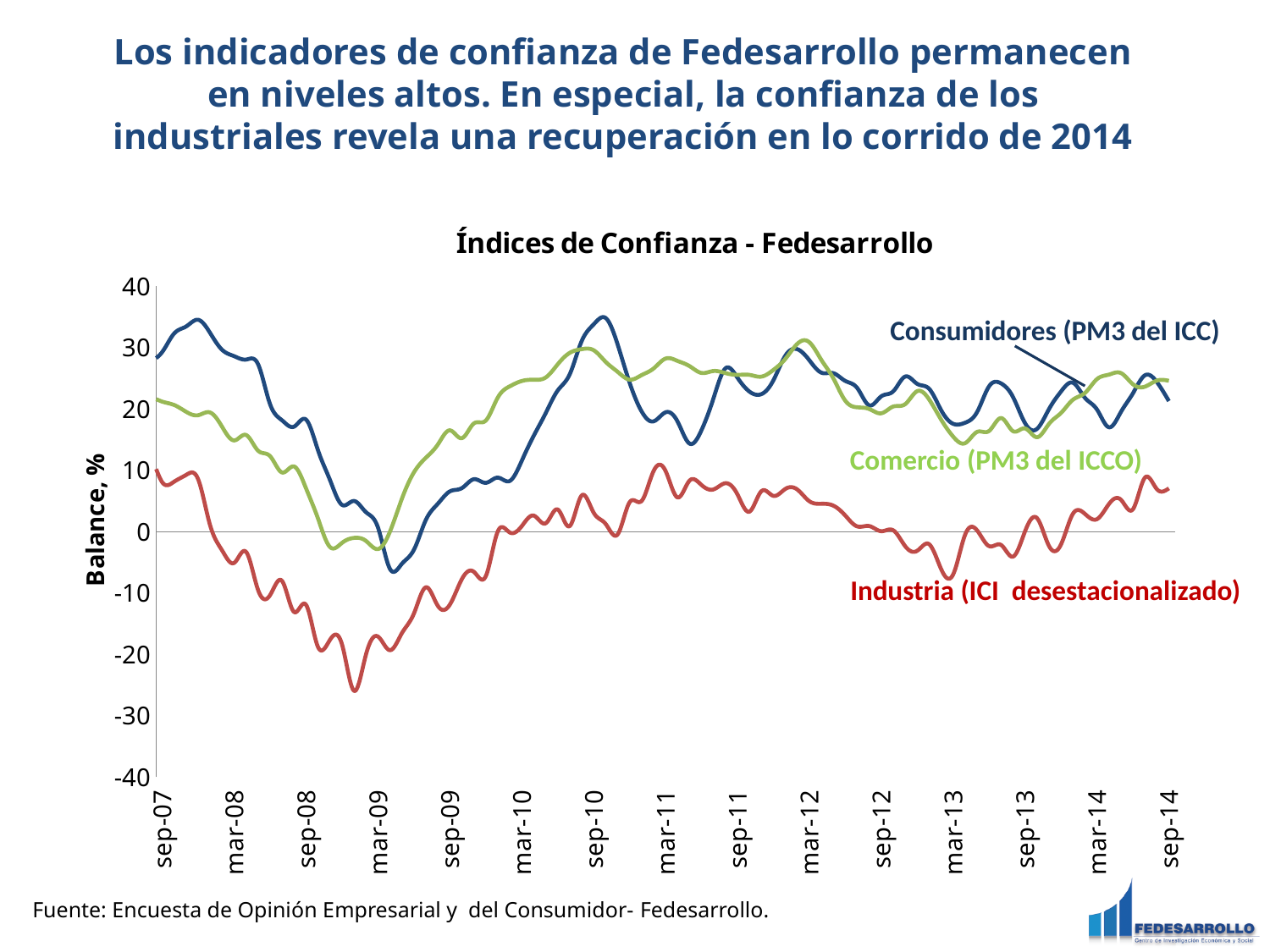
At mar-11, which series has the higher value: Comercio (PM3 del ICCO) or Consumidores (PM3 del ICC)? Comercio (PM3 del ICCO) Which series reaches the lowest value on the chart? Industria (ICI desestacionalizado) Is the lowest value of the Industria (ICI desestacionalizado) series greater or less than -20? less What is the title of the chart? Índices de Confianza - Fedesarrollo What kind of chart is shown on the slide? Line chart What is the label of the vertical axis? Balance, % Is the value of Industria (ICI desestacionalizado) at mar-11 greater or less than 0? greater How many series are plotted in the chart 'Índices de Confianza - Fedesarrollo'? 3 Is the value of Consumidores (PM3 del ICC) at sep-10 greater or less than 30? greater At mar-09, which series has the lower value: Consumidores (PM3 del ICC) or Industria (ICI desestacionalizado)? Industria (ICI desestacionalizado) Does the Industria (ICI desestacionalizado) series rise or fall between sep-07 and mar-09? Fall